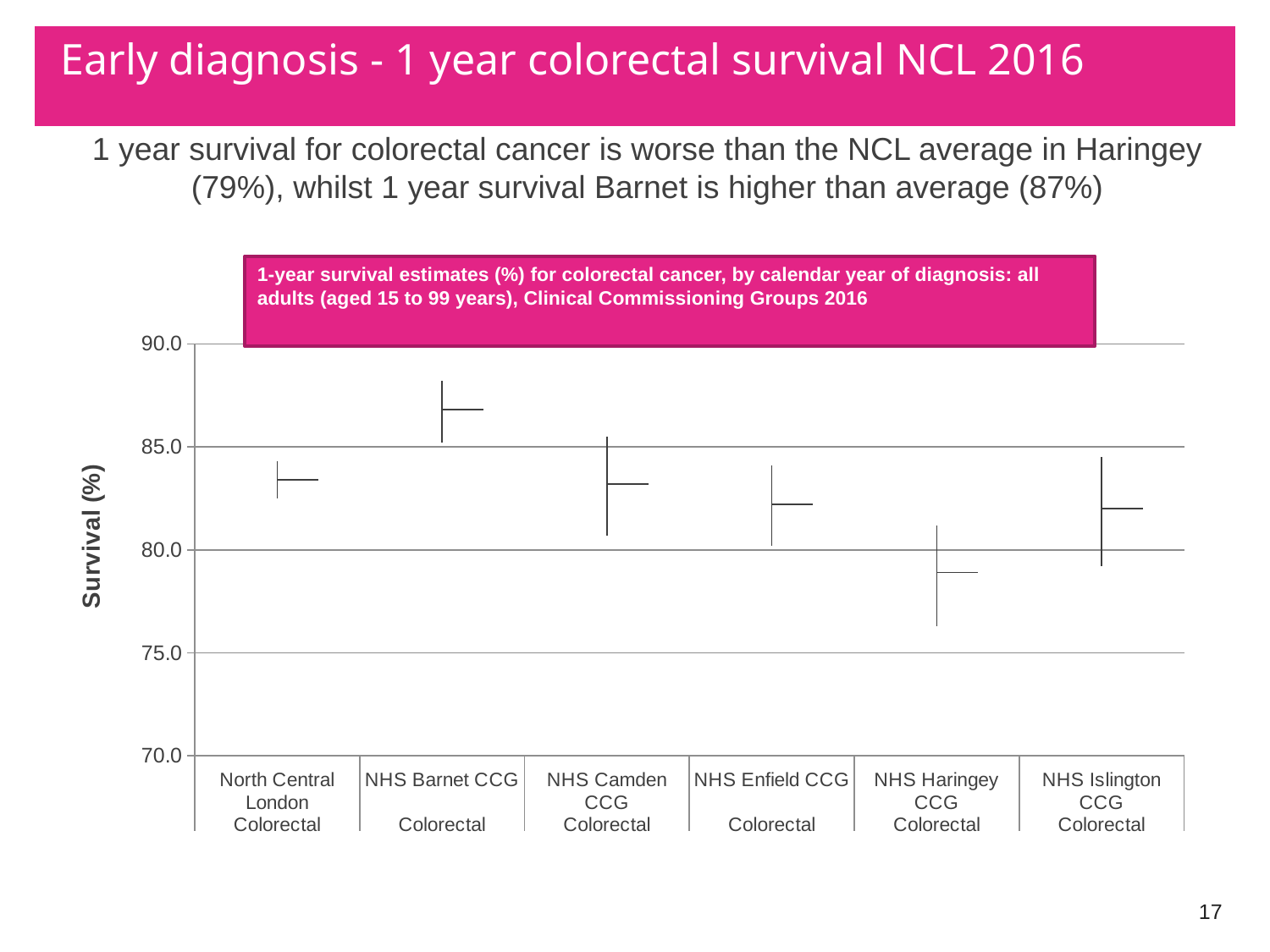
Is the survival estimate for North Central London Colorectal greater or less than 80.0? greater Is the survival estimate for NHS Enfield CCG Colorectal greater or less than 85.0? less Which category has the highest 1-year survival estimate on the chart? NHS Barnet CCG Colorectal Is the survival estimate for NHS Haringey CCG Colorectal greater or less than 80.0? less Which category has the lowest 1-year survival estimate on the chart? NHS Haringey CCG Colorectal What is the label of the vertical axis of the chart? Survival (%) Which has the higher survival estimate: NHS Barnet CCG Colorectal or NHS Enfield CCG Colorectal? NHS Barnet CCG Colorectal What is the lowest value shown on the vertical axis of the chart? 70.0 Which has the higher survival estimate: North Central London Colorectal or NHS Haringey CCG Colorectal? North Central London Colorectal How many categories are shown on the x axis of the chart? 6 Which has the higher survival estimate: NHS Barnet CCG Colorectal or NHS Haringey CCG Colorectal? NHS Barnet CCG Colorectal